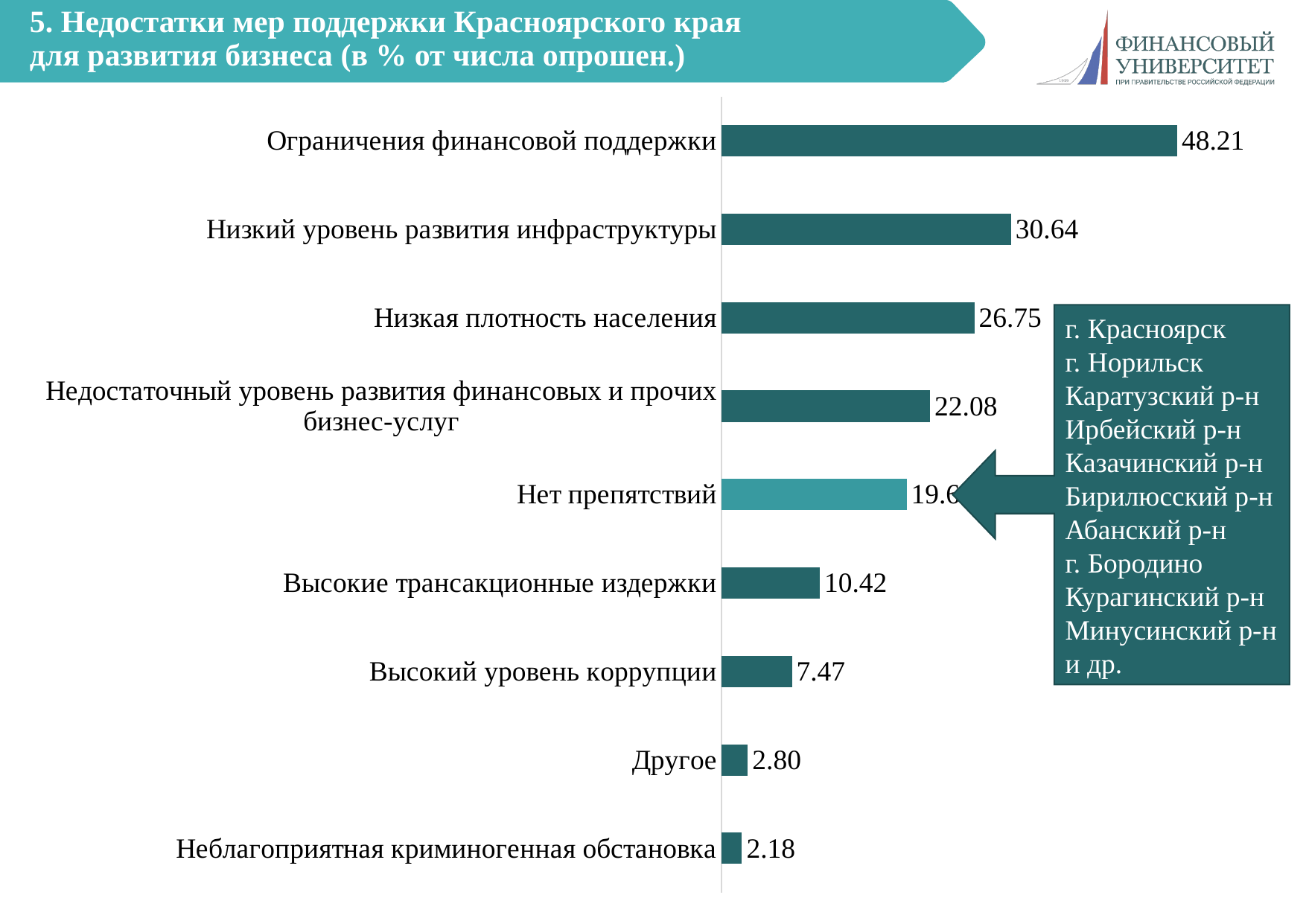
Which is larger: the value for "Низкая плотность населения" or for "Недостаточный уровень развития финансовых и прочих бизнес-услуг"? Низкая плотность населения What is the value for "Высокие трансакционные издержки"? 10.42 Which category's bar is drawn in a lighter colour than the others? Нет препятствий How many categories does the chart show? 9 What is the value for "Низкий уровень развития инфраструктуры"? 30.64 What is the difference between the values for "Ограничения финансовой поддержки" and "Низкий уровень развития инфраструктуры"? 17.57 Which category has the lowest value? Неблагоприятная криминогенная обстановка Which category has the highest value? Ограничения финансовой поддержки What is the value for "Другое"? 2.80 What kind of chart is shown on the slide? Bar chart What is the value for "Ограничения финансовой поддержки"? 48.21 What is the difference between the values for "Высокие трансакционные издержки" and "Высокий уровень коррупции"? 2.95